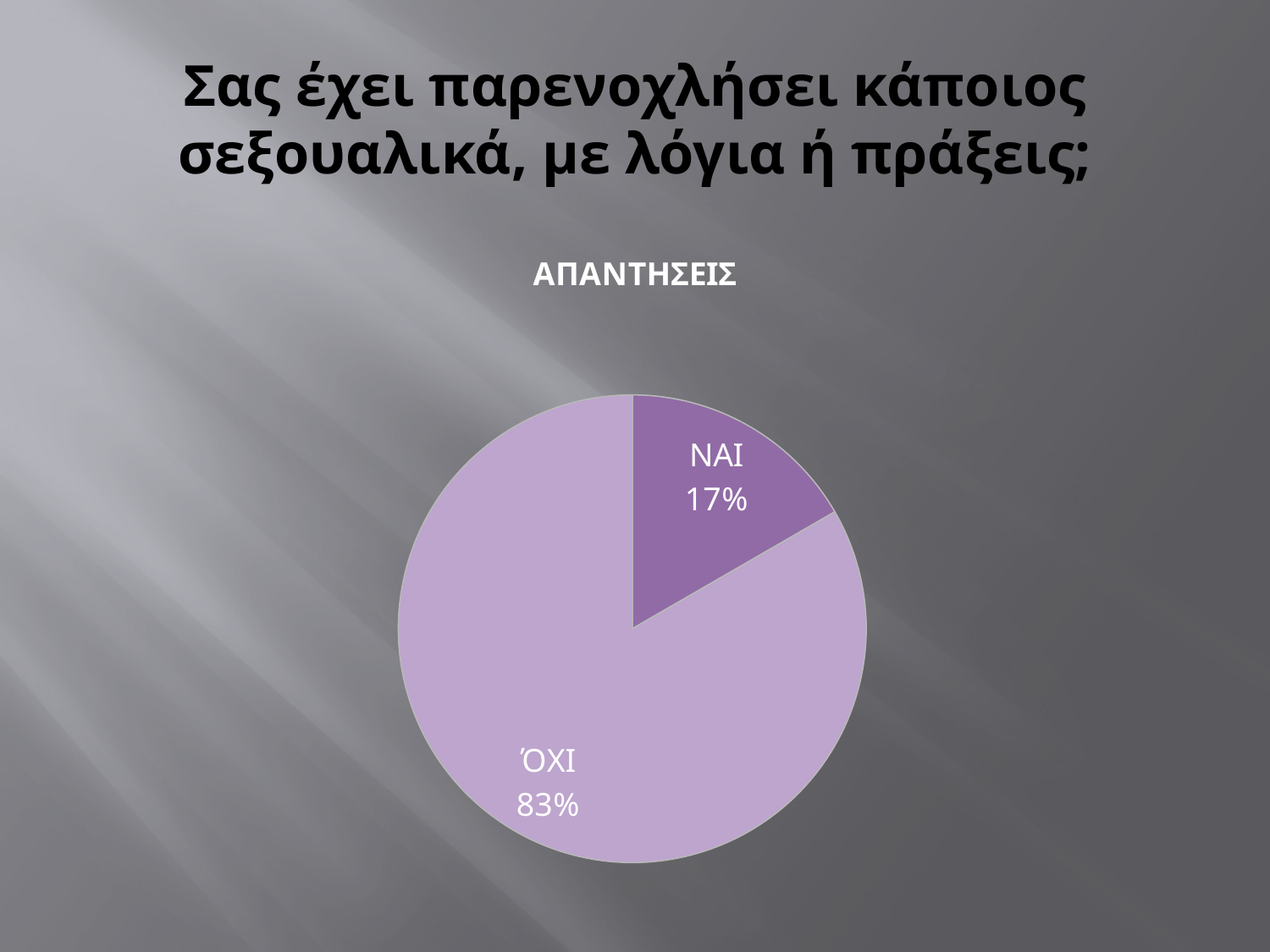
Which slice is the largest in the pie chart? ΌΧΙ What is the combined percentage of the ΝΑΙ and ΌΧΙ slices? 100% Which slice is the smallest in the pie chart? ΝΑΙ How many slices does the pie chart have? 2 What is the title of the chart? ΑΠΑΝΤΗΣΕΙΣ What is the difference in percentage points between the ΌΧΙ and ΝΑΙ slices? 66 What type of chart is shown on the slide? pie chart What percentage of the pie is the ΝΑΙ slice? 17% Which slice is shown in the darker purple colour? ΝΑΙ Which is larger, the ΝΑΙ slice or the ΌΧΙ slice? ΌΧΙ What percentage of the pie is the ΌΧΙ slice? 83%